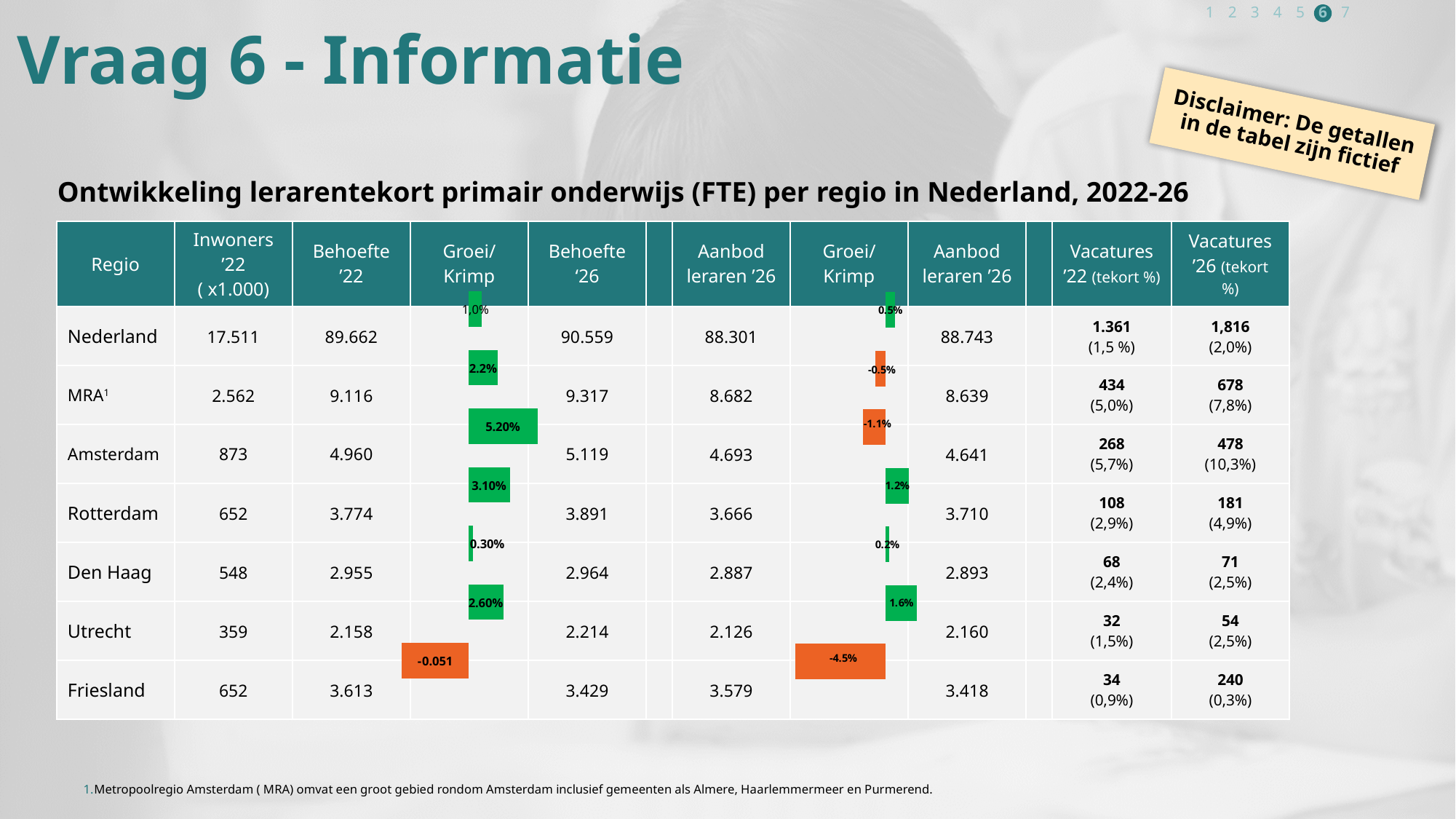
In the right Groei/Krimp chart (between the Aanbod leraren '26 columns), which region has the highest value? Utrecht How many bars does the left Groei/Krimp chart (between Behoefte '22 and Behoefte '26) contain? 7 In the left Groei/Krimp chart (between Behoefte '22 and Behoefte '26), which region has the highest value? Amsterdam In the left Groei/Krimp chart (between Behoefte '22 and Behoefte '26), what is the value shown for Amsterdam? 5.20% In the right Groei/Krimp chart (between the Aanbod leraren '26 columns), which region has the lowest value? Friesland In the left Groei/Krimp chart (between Behoefte '22 and Behoefte '26), what is the value shown for Den Haag? 0.30% In the right Groei/Krimp chart (between the Aanbod leraren '26 columns), which is larger: the value for Rotterdam or the value for Den Haag? Rotterdam What kind of chart is used in the Groei/Krimp columns of the table? Bar chart In the right Groei/Krimp chart (between the Aanbod leraren '26 columns), what is the value shown for Utrecht? 1.6% In the right Groei/Krimp chart (between the Aanbod leraren '26 columns), what is the value shown for Friesland? -4.5% In the right Groei/Krimp chart (between the Aanbod leraren '26 columns), how many bars are coloured orange? 3 In the left Groei/Krimp chart (between Behoefte '22 and Behoefte '26), what is the difference between the values for Amsterdam and Rotterdam? 2.10%